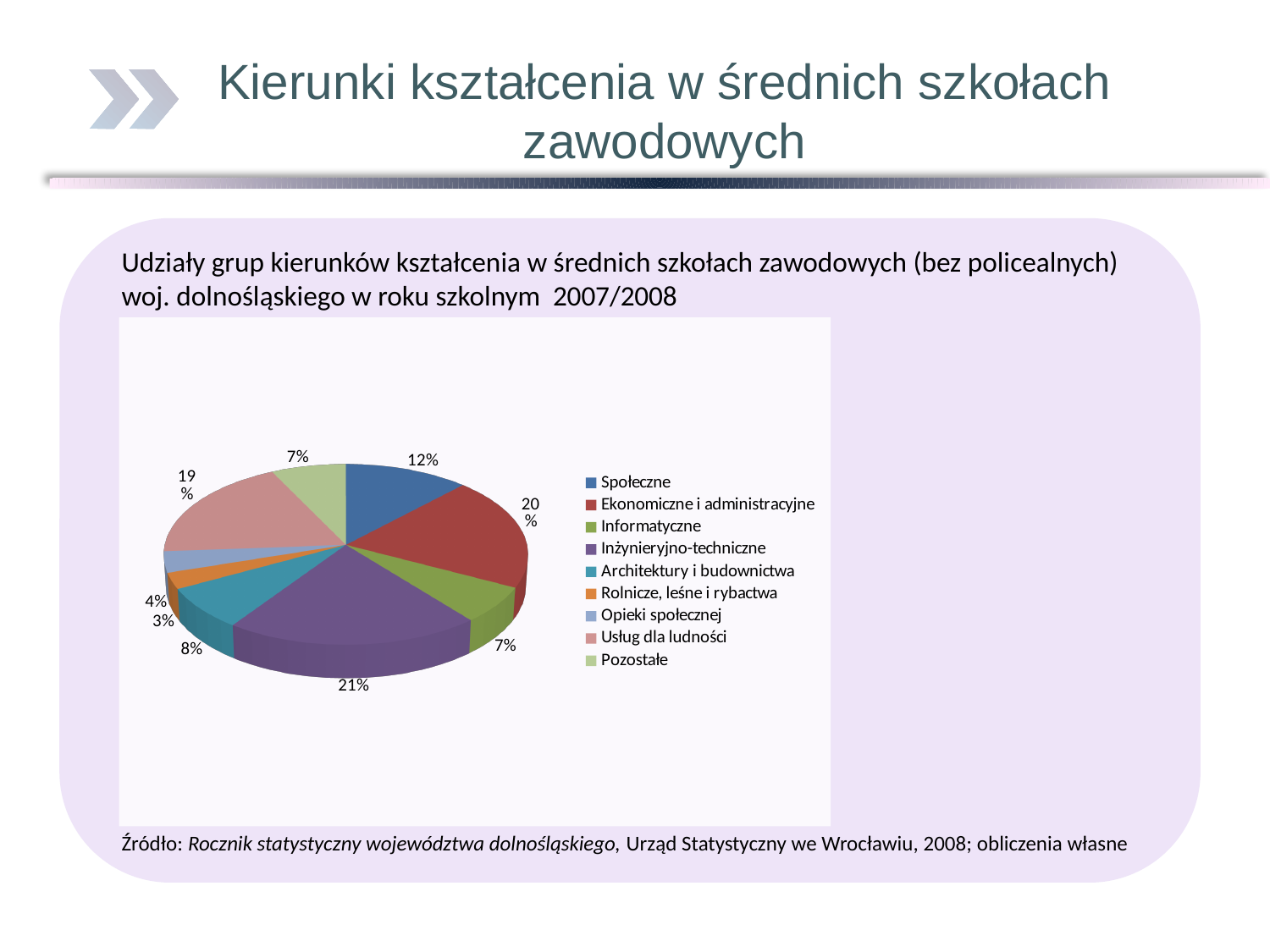
What share of the pie does Usług dla ludności have? 19% What share of the pie does Ekonomiczne i administracyjne have? 20% Which category is shown in orange in the legend? Rolnicze, leśne i rybactwa Which category has the largest share of the pie? Inżynieryjno-techniczne What share of the pie does Architektury i budownictwa have? 8% How many categories does the legend list? 9 Which category has the smallest share of the pie? Rolnicze, leśne i rybactwa What share of the pie does Opieki społecznej have? 4% What is the difference between the shares of Inżynieryjno-techniczne and Informatyczne? 14% What share of the pie does Społeczne have? 12% Which has a larger share, Usług dla ludności or Społeczne? Usług dla ludności What type of chart is shown on the slide? pie chart